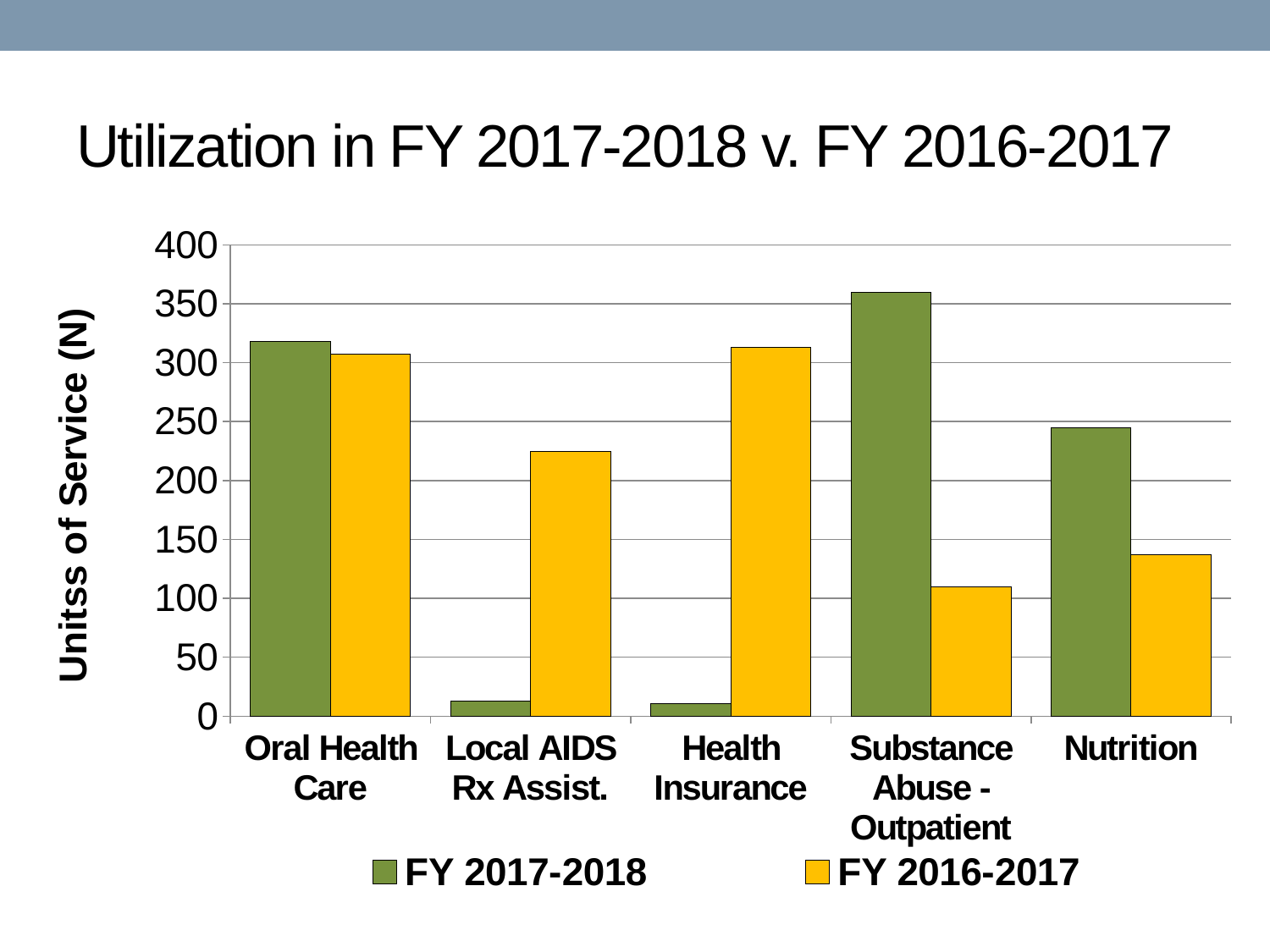
Is the FY 2016-2017 value for Local AIDS Rx Assist. greater or less than 200? greater Is the FY 2017-2018 value for Health Insurance greater or less than 50? less Which category has the highest value for FY 2017-2018? Substance Abuse - Outpatient Is the FY 2017-2018 value for Substance Abuse - Outpatient greater or less than 300? greater How many series does the legend list? 2 How many categories are shown on the x axis? 5 For Health Insurance, which is larger: FY 2017-2018 or FY 2016-2017? FY 2016-2017 For Nutrition, which is larger: FY 2017-2018 or FY 2016-2017? FY 2017-2018 Which category has the lowest value for FY 2016-2017? Substance Abuse - Outpatient What is the label on the y axis of the chart? Unitss of Service (N) What kind of chart is shown on the slide? bar chart